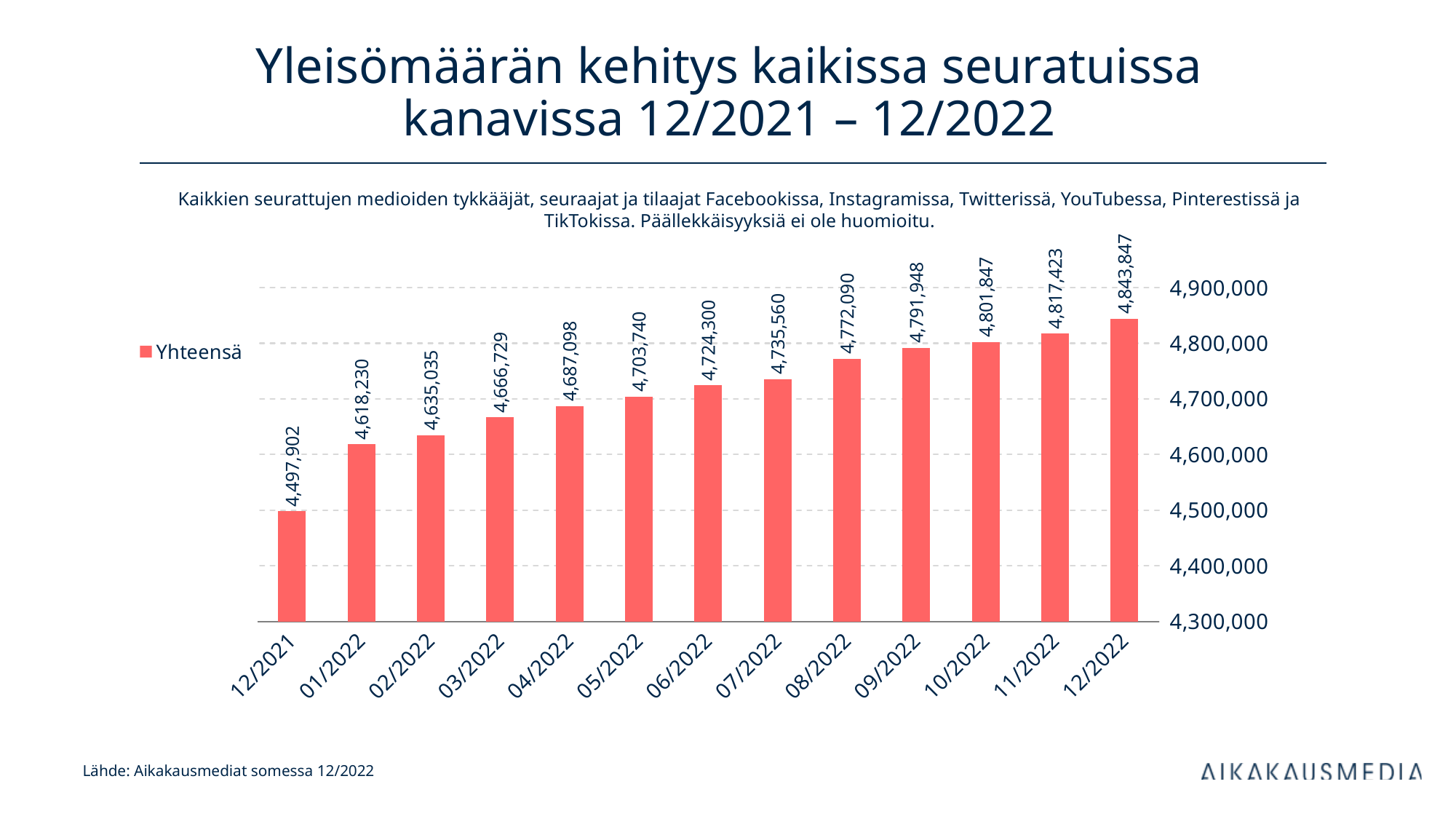
What is the value for 06/2022? 4,724,300 What is the value for 12/2022? 4,843,847 What is the difference between the values for 12/2022 and 12/2021? 345,945 What is the value for 12/2021? 4,497,902 Which month has the lowest value? 12/2021 Do the values rise or fall from 12/2021 to 12/2022? rise How many months are shown on the x axis? 13 Which is larger, the value for 03/2022 or the value for 09/2022? 09/2022 Which month has the highest value? 12/2022 What kind of chart is shown on the slide? bar chart Is the value for 08/2022 greater or less than 4,700,000? greater What is the difference between the values for 01/2022 and 12/2021? 120,328